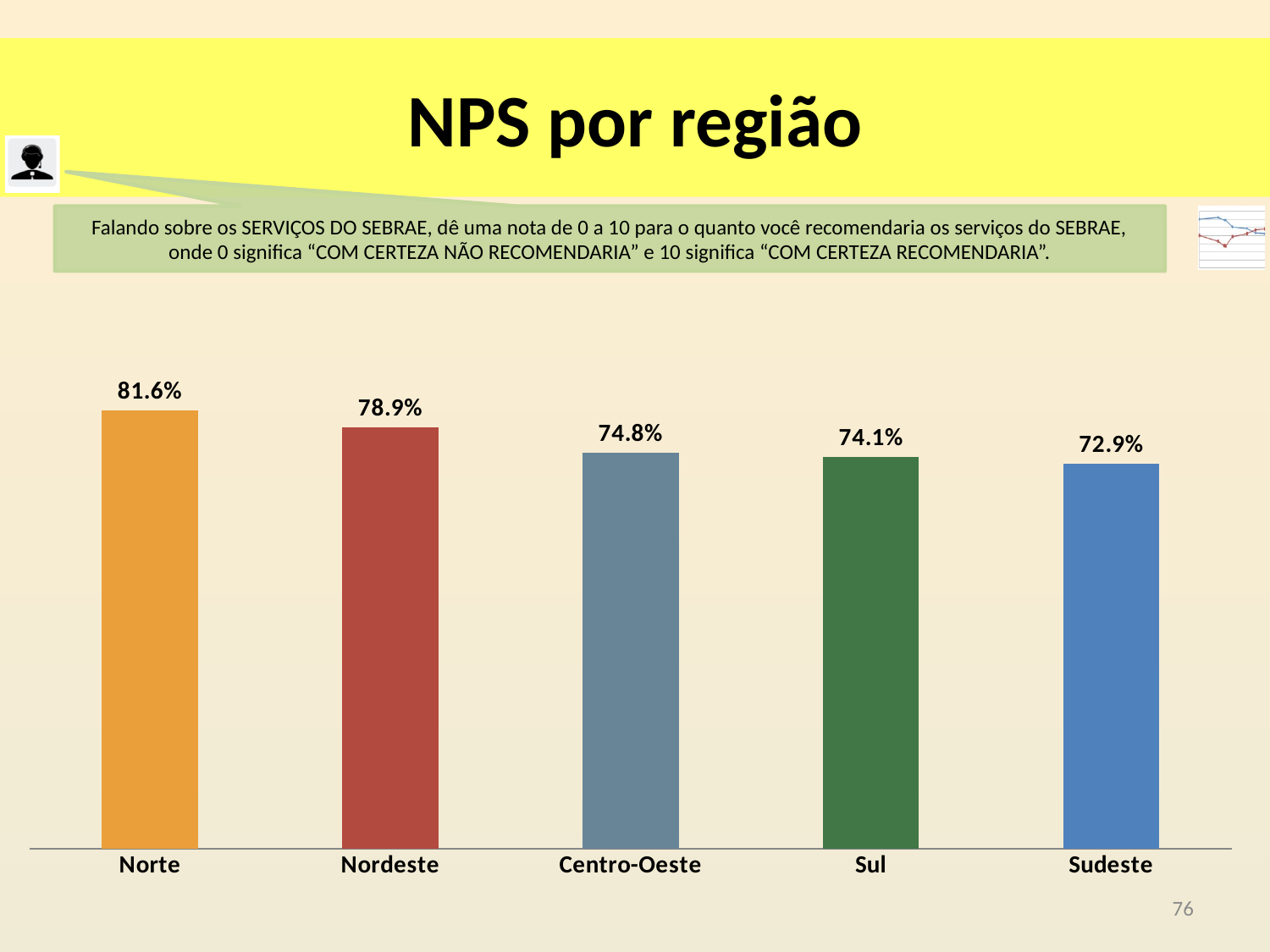
What is the NPS value for Sul? 74.1% Which has a higher NPS, Nordeste or Sul? Nordeste What is the difference between the NPS for Norte and the NPS for Sudeste? 8.7% How many regions are shown in the chart? 5 What type of chart is shown on the slide? Bar chart What is the NPS value for Nordeste? 78.9% Which region has the highest NPS? Norte What is the NPS value for Norte? 81.6% What is the difference between the NPS for Nordeste and the NPS for Centro-Oeste? 4.1% What is the NPS value for Sudeste? 72.9% Which region has the lowest NPS? Sudeste What is the NPS value for Centro-Oeste? 74.8%